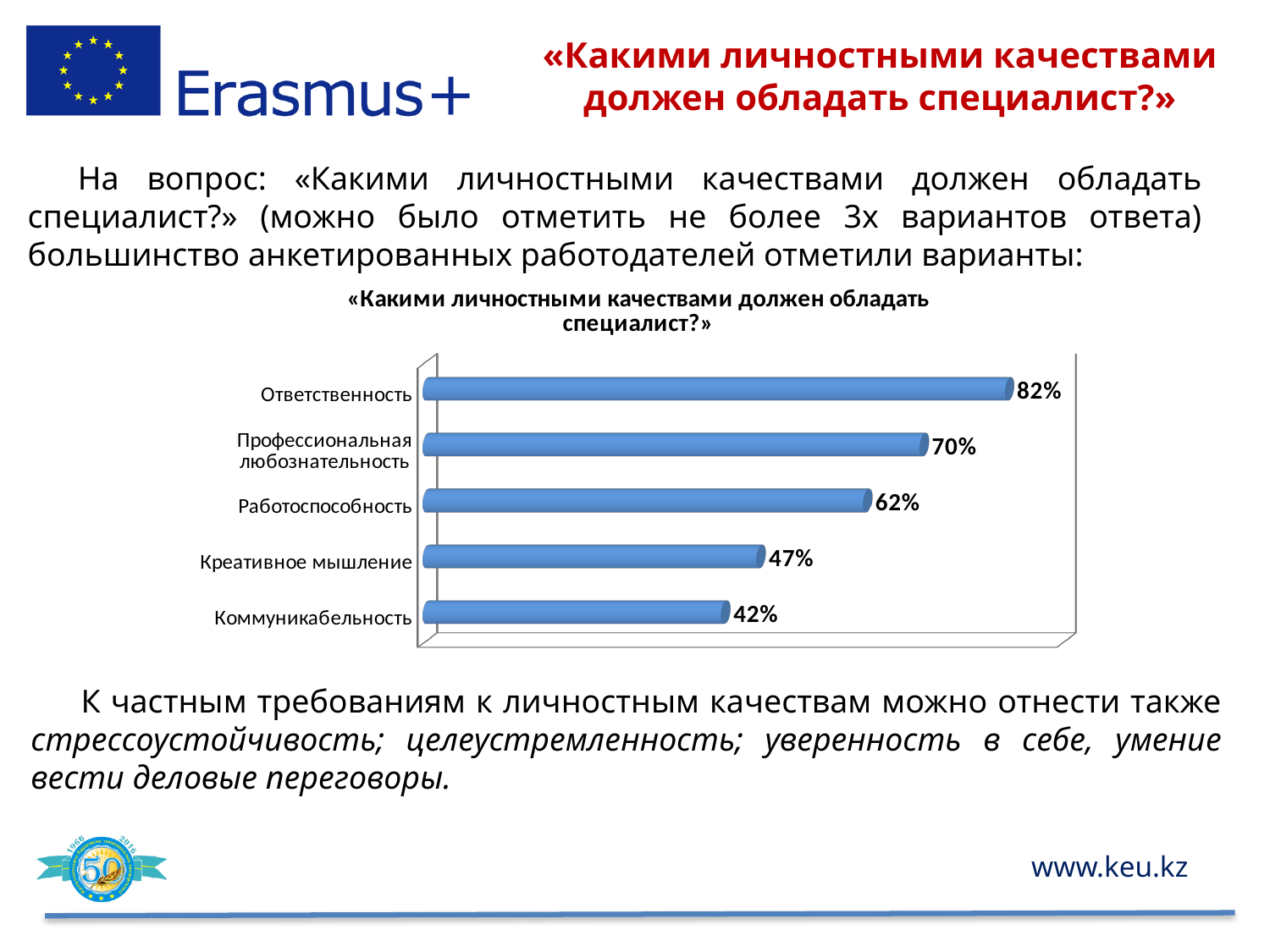
How many categories are shown in the chart? 5 What value is shown for Ответственность? 82% Which is larger, the value for Работоспособность or the value for Креативное мышление? Работоспособность Which category has the highest value? Ответственность Which category has the lowest value? Коммуникабельность What is the difference between the values for Ответственность and Коммуникабельность? 40% What value is shown for Профессиональная любознательность? 70% What value is shown for Коммуникабельность? 42% What kind of chart is shown on the slide? Bar chart What value is shown for Креативное мышление? 47% What value is shown for Работоспособность? 62% What is the title of the chart? «Какими личностными качествами должен обладать специалист?»